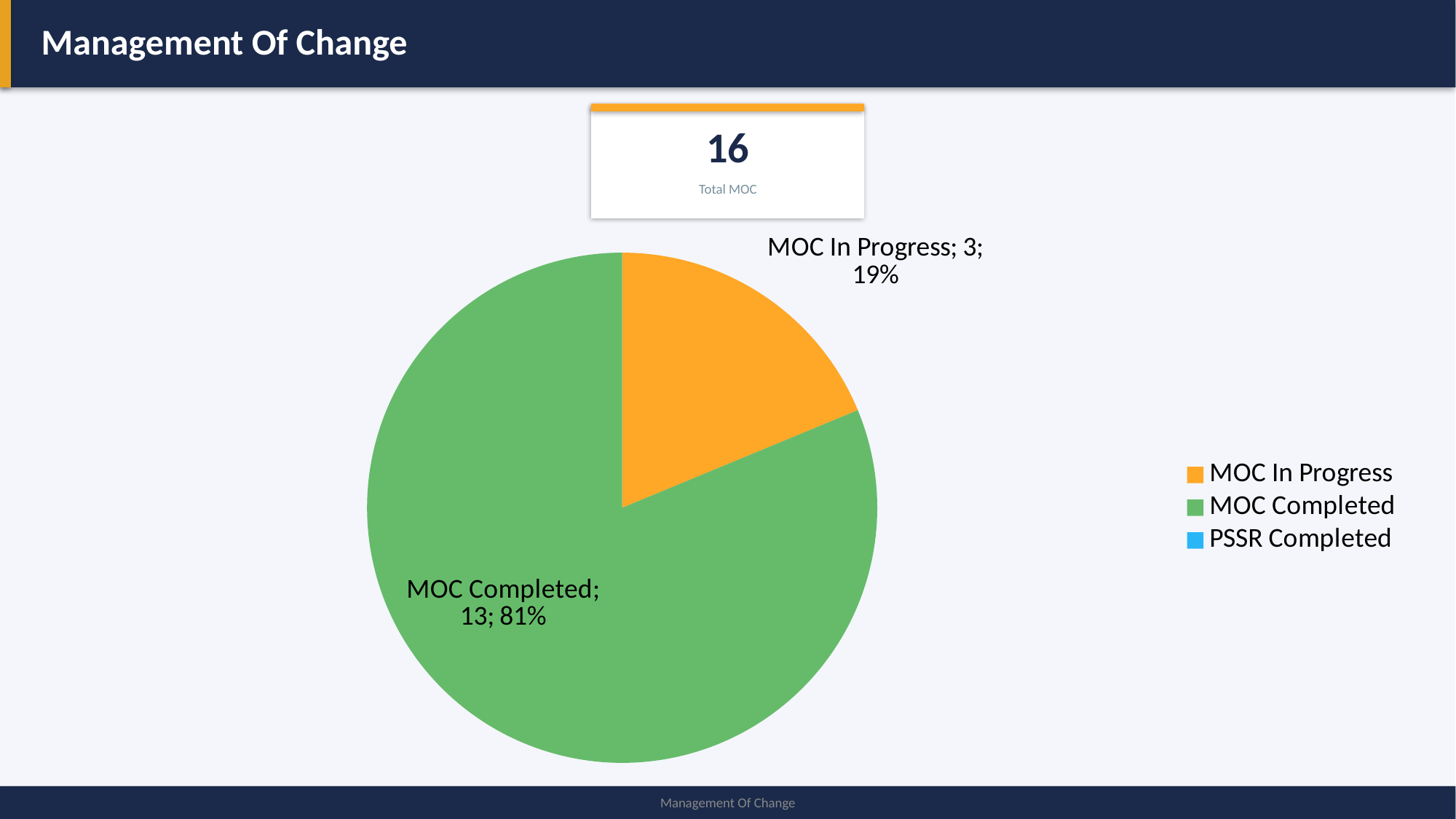
What is the value for MOC Completed? 13 Which category has the largest slice of the pie? MOC Completed Is the value for MOC Completed larger than the value for MOC In Progress? Yes What is the Total MOC figure shown above the chart? 16 What is the difference between the MOC Completed value and the MOC In Progress value? 10 How many entries does the legend list? 3 What share of the pie does MOC In Progress represent? 19% What share of the pie does MOC Completed represent? 81% What is the value for MOC In Progress? 3 What kind of chart is shown on the slide? pie chart What colour is the MOC In Progress slice? orange Which of the two labelled slices is smaller, MOC In Progress or MOC Completed? MOC In Progress